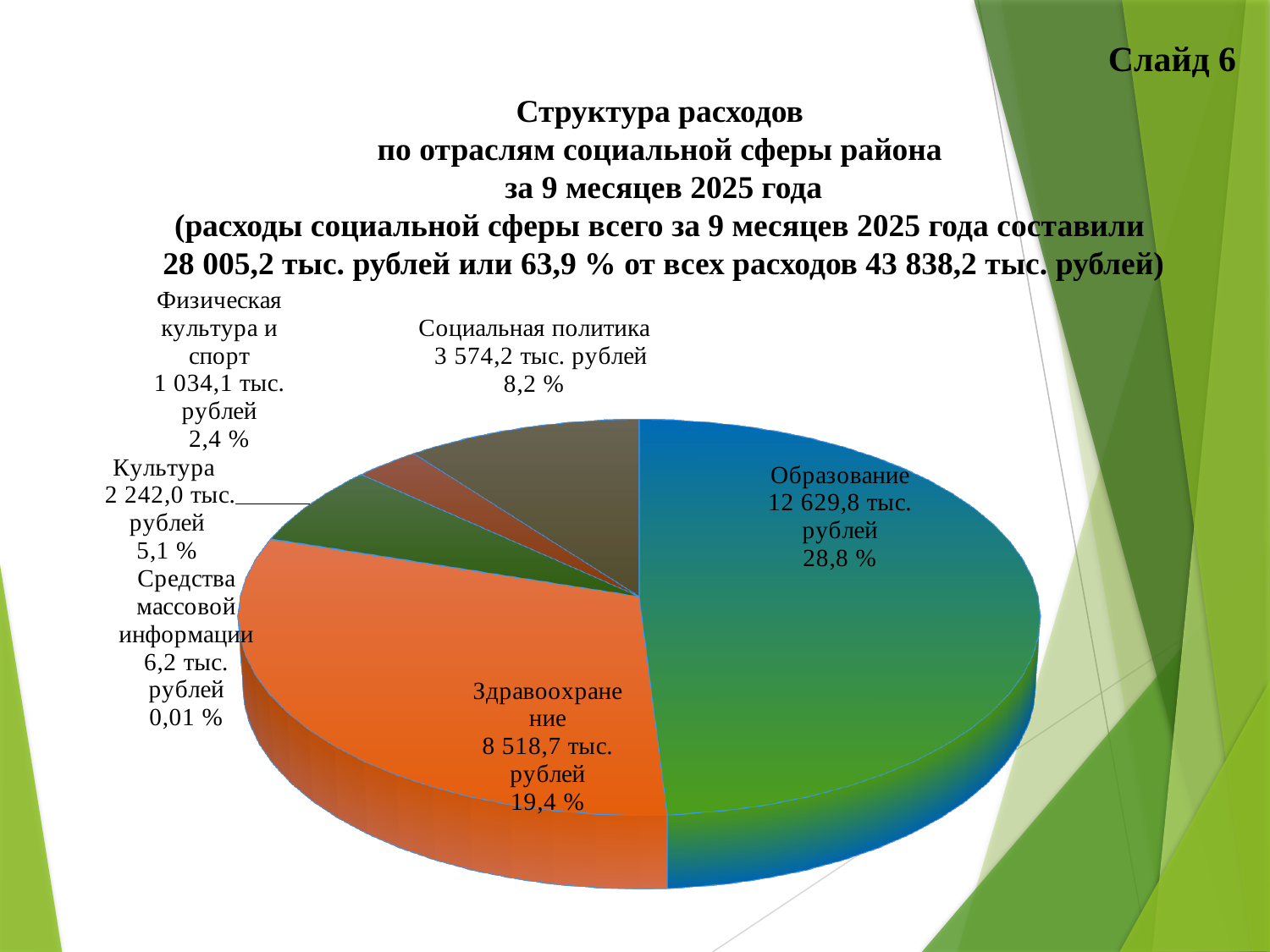
Which category has the largest slice of the pie chart? Образование Which is larger, the value for Социальная политика or the value for Культура? Социальная политика What kind of chart is shown on the slide? Pie chart What is the difference between the values for Образование and Здравоохранение? 4 111,1 тыс. рублей What percentage is shown for Средства массовой информации on the pie chart? 0,01 % What value is shown for Здравоохранение on the pie chart? 8 518,7 тыс. рублей What value is shown for Социальная политика on the pie chart? 3 574,2 тыс. рублей What value is shown for Культура on the pie chart? 2 242,0 тыс. рублей What value is shown for Образование on the pie chart? 12 629,8 тыс. рублей Which category has the smallest slice of the pie chart? Средства массовой информации How many categories are shown on the pie chart? 6 What percentage is shown for Физическая культура и спорт on the pie chart? 2,4 %